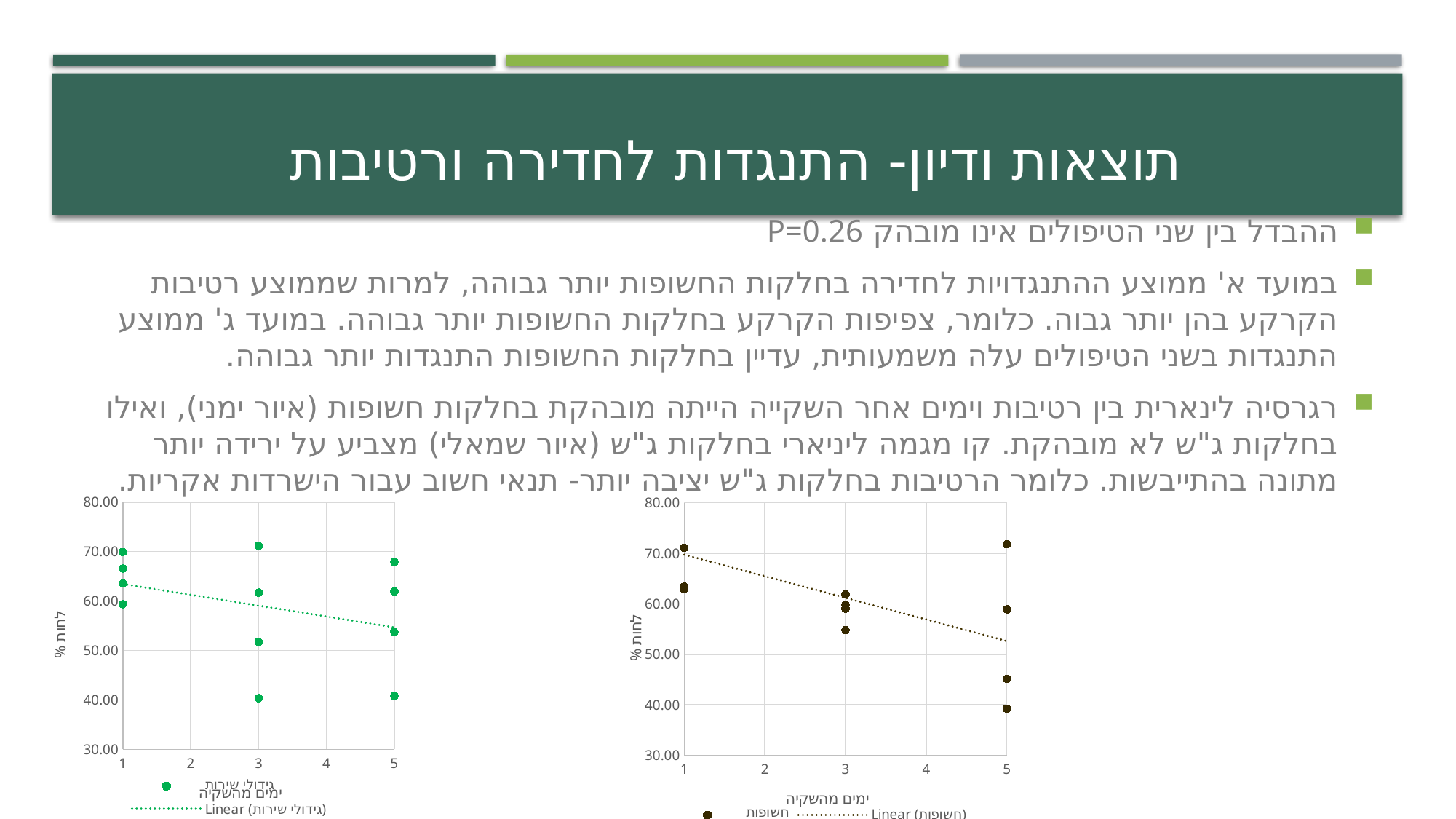
In the left chart (גידולי שירות), is the lowest point at day 3 greater or less than 50.00? less At how many distinct x-axis values (days) are data points plotted in the left chart (גידולי שירות)? 3 What is the y-axis label of the right chart (חשופות)? % לחות What kind of chart is the right chart (חשופות)? scatter chart In the right chart (חשופות), is the lowest point at day 5 greater or less than 50.00? less In the right chart (חשופות), is the highest point at day 1 greater or less than 60.00? greater How many entries does the legend of the left chart (גידולי שירות) list? 2 In the right chart (חשופות), does the linear trendline rise or fall as days since irrigation increase? fall How many entries does the legend of the right chart (חשופות) list? 2 In the left chart (גידולי שירות), does the linear trendline rise or fall as days since irrigation increase? fall What kind of chart is the left chart (גידולי שירות)? scatter chart